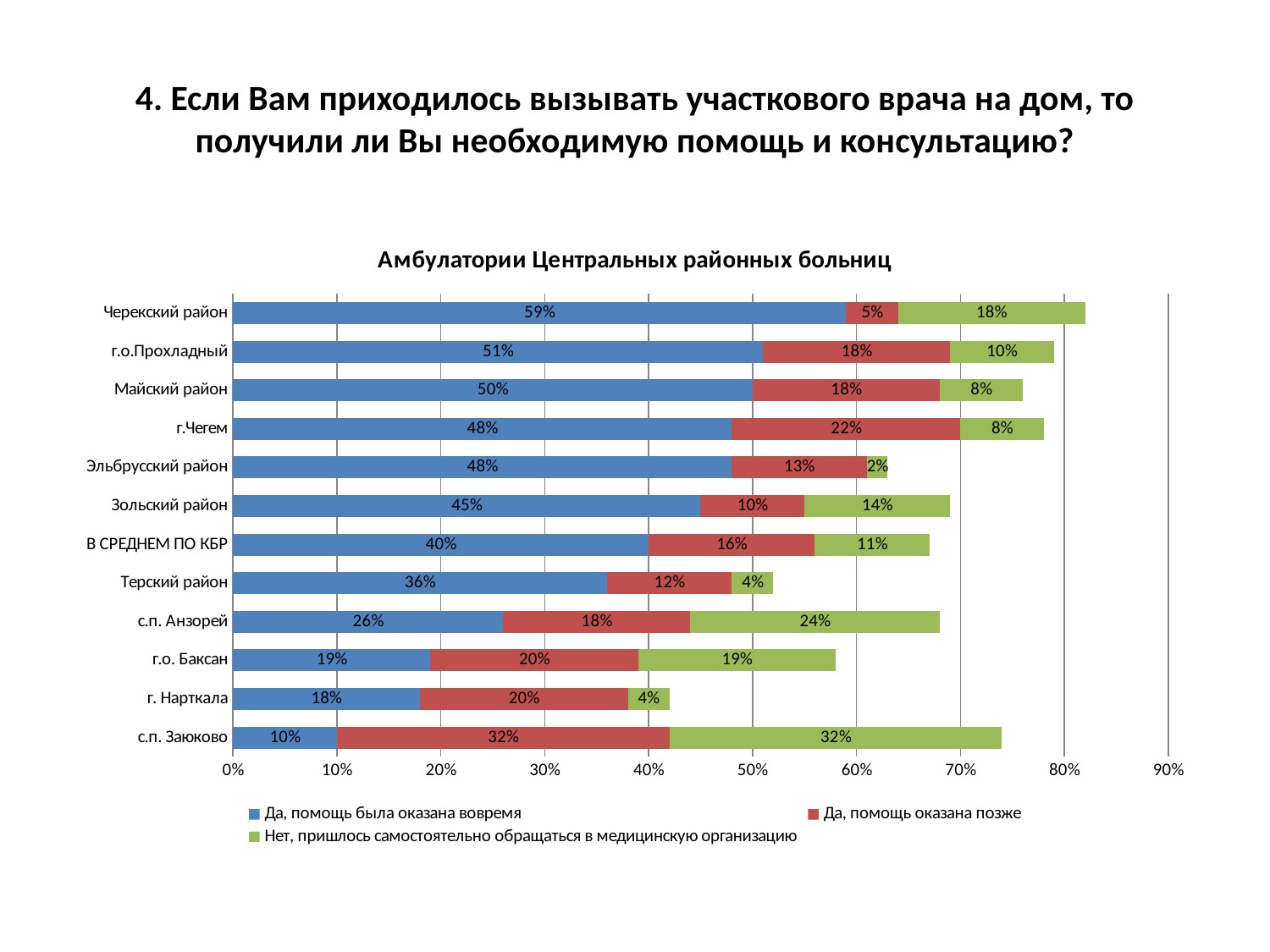
Which is larger: the "Нет, пришлось самостоятельно обращаться в медицинскую организацию" value for Зольский район or for г.о.Прохладный? Зольский район What is the value of "Нет, пришлось самостоятельно обращаться в медицинскую организацию" for с.п. Анзорей? 24% Which category has the highest value for "Да, помощь оказана позже"? с.п. Заюково Which category has the highest value for "Да, помощь была оказана вовремя"? Черекский район What type of chart is shown on the slide? Stacked bar chart How many categories are shown on the chart? 12 How many series does the legend list? 3 Which category has the lowest value for "Да, помощь была оказана вовремя"? с.п. Заюково What is the difference between the "Да, помощь была оказана вовремя" values for Черекский район and с.п. Заюково? 49% What is the value of "Да, помощь была оказана вовремя" for Черекский район? 59% What is the total of the stacked bar for с.п. Заюково? 74% What is the value of "Да, помощь оказана позже" for г.Чегем? 22%